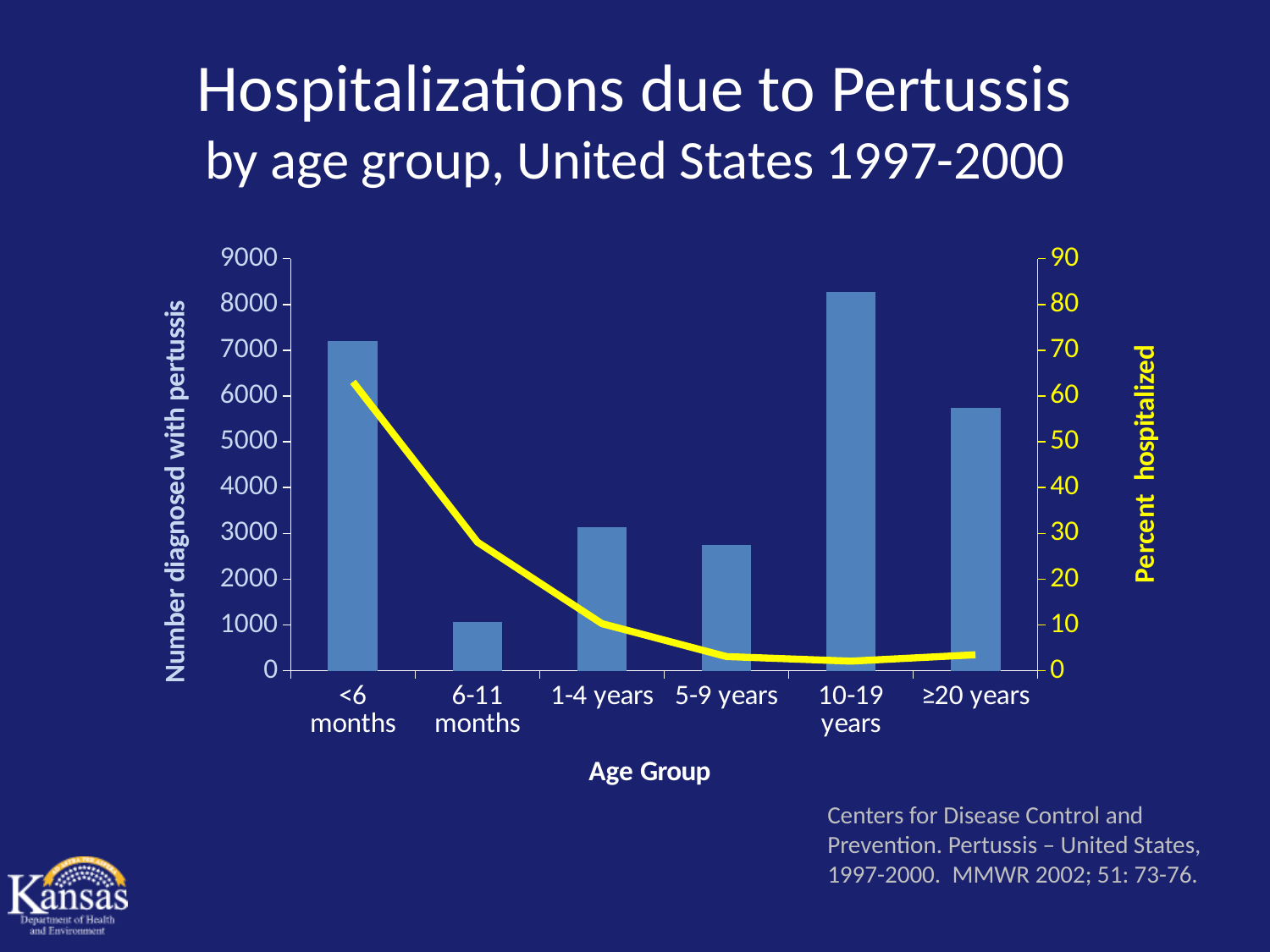
Does the percent hospitalized line generally rise or fall as age group increases from <6 months to 10-19 years? fall Is the number diagnosed with pertussis for the 10-19 years group greater or less than 8000? greater Is the number diagnosed with pertussis for the <6 months group greater or less than 7000? greater Is the percent hospitalized for the <6 months group greater or less than 60? greater How many age groups are shown on the x axis? 6 Which age group has the highest percent hospitalized? <6 months What is the label of the left vertical axis? Number diagnosed with pertussis Which age group has the highest number diagnosed with pertussis? 10-19 years Which has more people diagnosed with pertussis, the 1-4 years group or the ≥20 years group? ≥20 years Which age group has the lowest number diagnosed with pertussis? 6-11 months